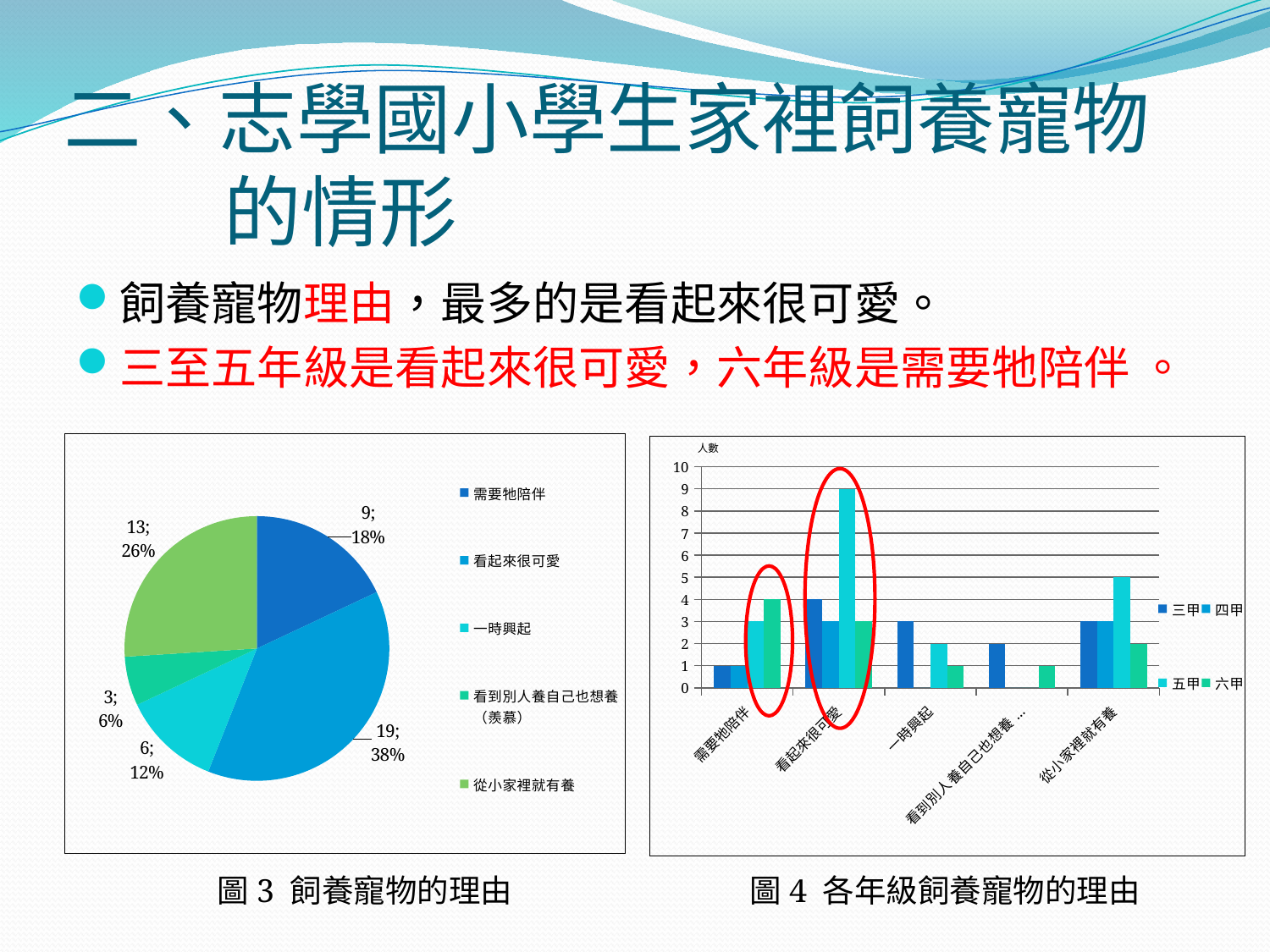
In 圖4 各年級飼養寵物的理由, which series has the tallest bar for 看起來很可愛? 五甲 In the pie chart 圖3 飼養寵物的理由, what value and percentage are shown for 看起來很可愛? 19; 38% In the pie chart 圖3 飼養寵物的理由, what is the difference between the counts for 看起來很可愛 and 需要牠陪伴? 10 In the pie chart 圖3 飼養寵物的理由, which reason has the smallest slice? 看到別人養自己也想養（羨慕） How many series does the legend of 圖4 各年級飼養寵物的理由 list? 4 In 圖4 各年級飼養寵物的理由, is the value for 五甲 under 看起來很可愛 greater or less than 8? greater In the pie chart 圖3 飼養寵物的理由, what percentage is shown for 從小家裡就有養? 26% In the pie chart 圖3 飼養寵物的理由, how many slices does the pie have? 5 In the pie chart 圖3 飼養寵物的理由, which is larger: 一時興起 or 看到別人養自己也想養（羨慕）? 一時興起 In 圖4 各年級飼養寵物的理由, what is the label on the vertical axis? 人數 In the pie chart 圖3 飼養寵物的理由, which reason has the largest slice? 看起來很可愛 What kind of chart is 圖4 各年級飼養寵物的理由? bar chart